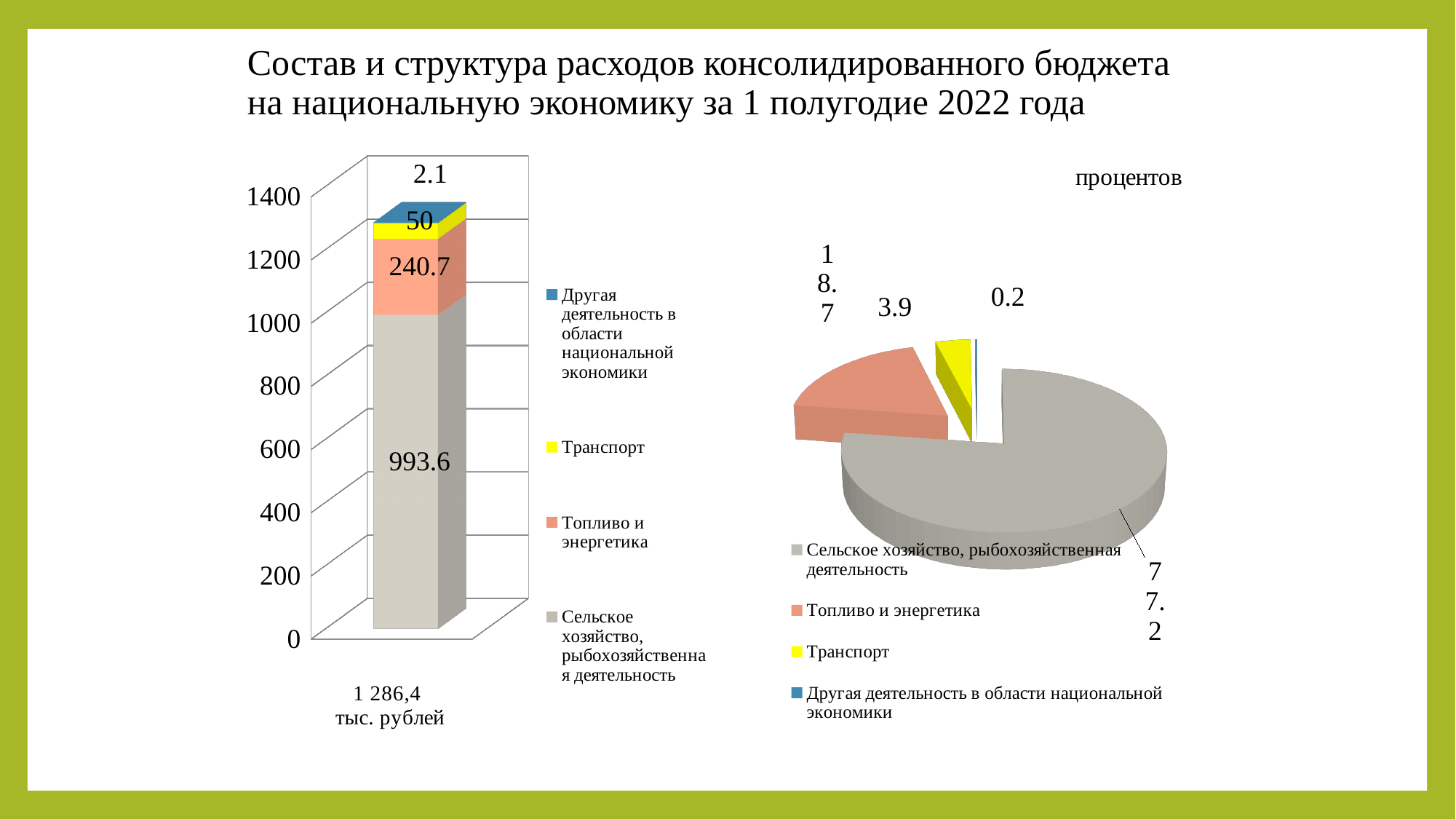
On the left stacked bar chart, what is the total of the stacked bar as printed on the slide? 1 286,4 тыс. рублей On the left stacked bar chart, what is the difference between the values for Топливо и энергетика and Транспорт? 190.7 What kind of chart is the chart on the right of the slide? Pie chart On the left stacked bar chart, what is the value for Транспорт? 50 On the left stacked bar chart, what is the value for Другая деятельность в области национальной экономики? 2.1 On the left stacked bar chart, which series has the largest value? Сельское хозяйство, рыбохозяйственная деятельность On the left stacked bar chart, which series has the smallest value? Другая деятельность в области национальной экономики On the right pie chart, what share does Сельское хозяйство, рыбохозяйственная деятельность have? 77.2 How many series does the legend of the left stacked bar chart list? 4 On the right pie chart, what share does Топливо и энергетика have? 18.7 On the left stacked bar chart, what is the value for Сельское хозяйство, рыбохозяйственная деятельность? 993.6 On the left stacked bar chart, what is the value for Топливо и энергетика? 240.7